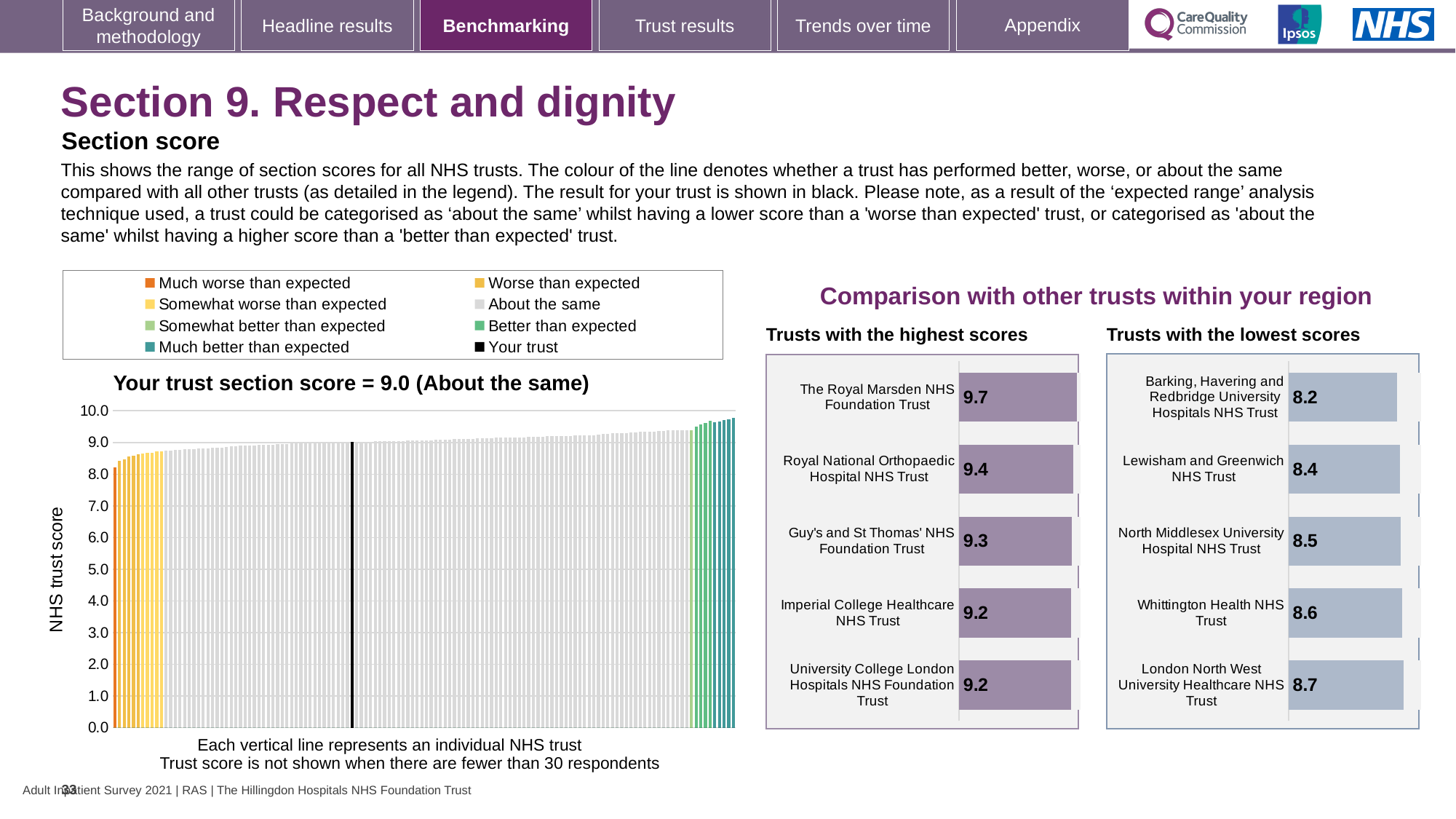
In the 'Trusts with the highest scores' chart, what is the score for The Royal Marsden NHS Foundation Trust? 9.7 In the 'Trusts with the highest scores' chart, what is the score for Guy's and St Thomas' NHS Foundation Trust? 9.3 In the 'Trusts with the highest scores' chart, what is the difference between the scores of The Royal Marsden NHS Foundation Trust and Royal National Orthopaedic Hospital NHS Trust? 0.3 In the 'Trusts with the lowest scores' chart, which trust has the lowest score? Barking, Havering and Redbridge University Hospitals NHS Trust How many trusts are listed in the 'Trusts with the lowest scores' chart? 5 In the 'Trusts with the highest scores' chart, which trust has the highest score? The Royal Marsden NHS Foundation Trust What kind of chart is the main chart on the left showing the range of section scores for all NHS trusts? Bar chart In the 'Trusts with the lowest scores' chart, what is the difference between the scores of London North West University Healthcare NHS Trust and Barking, Havering and Redbridge University Hospitals NHS Trust? 0.5 In the main chart on the left, do the trust scores rise or fall from left to right along the x axis? Rise In the main chart on the left, what is the section score for your trust, as stated in the chart title? 9.0 In the 'Trusts with the lowest scores' chart, which has the higher score: Whittington Health NHS Trust or North Middlesex University Hospital NHS Trust? Whittington Health NHS Trust In the 'Trusts with the lowest scores' chart, what is the score for Lewisham and Greenwich NHS Trust? 8.4